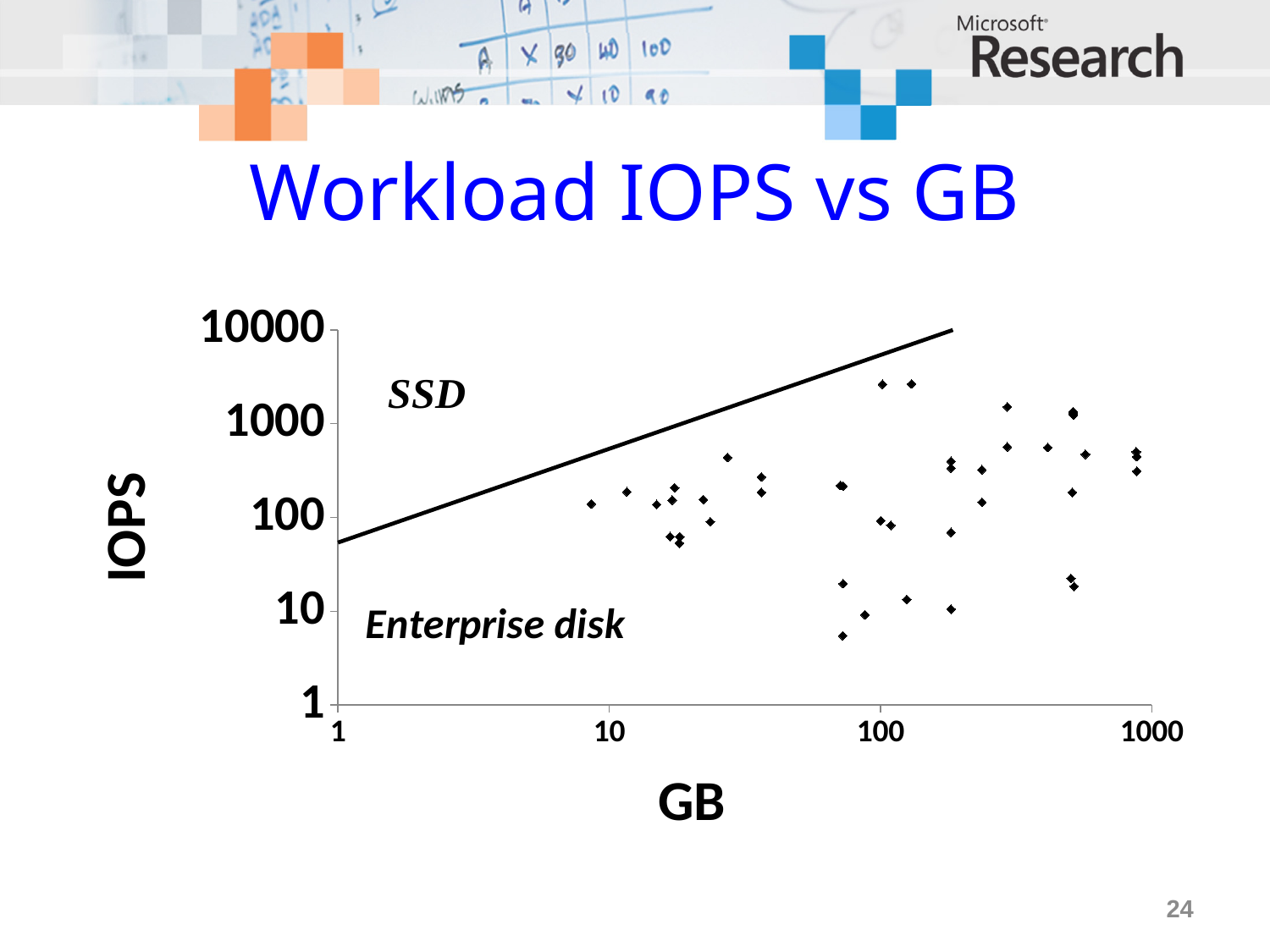
Does the diagonal line rise or fall as GB increases? Rises Is the IOPS value of the lowest plotted point greater or less than 10? less Is the IOPS value of the highest plotted point greater or less than 1000? greater What label is on the y axis of the chart? IOPS What is the title of the chart? Workload IOPS vs GB Is the IOPS value of the highest plotted point greater or less than 10000? less What kind of chart is shown on the slide? Scatter chart What is the highest tick value shown on the y axis? 10000 Are the plotted data points above or below the diagonal line? Below Which region label appears below the diagonal line? Enterprise disk What is the highest tick value shown on the x axis? 1000 Which region label appears above the diagonal line? SSD